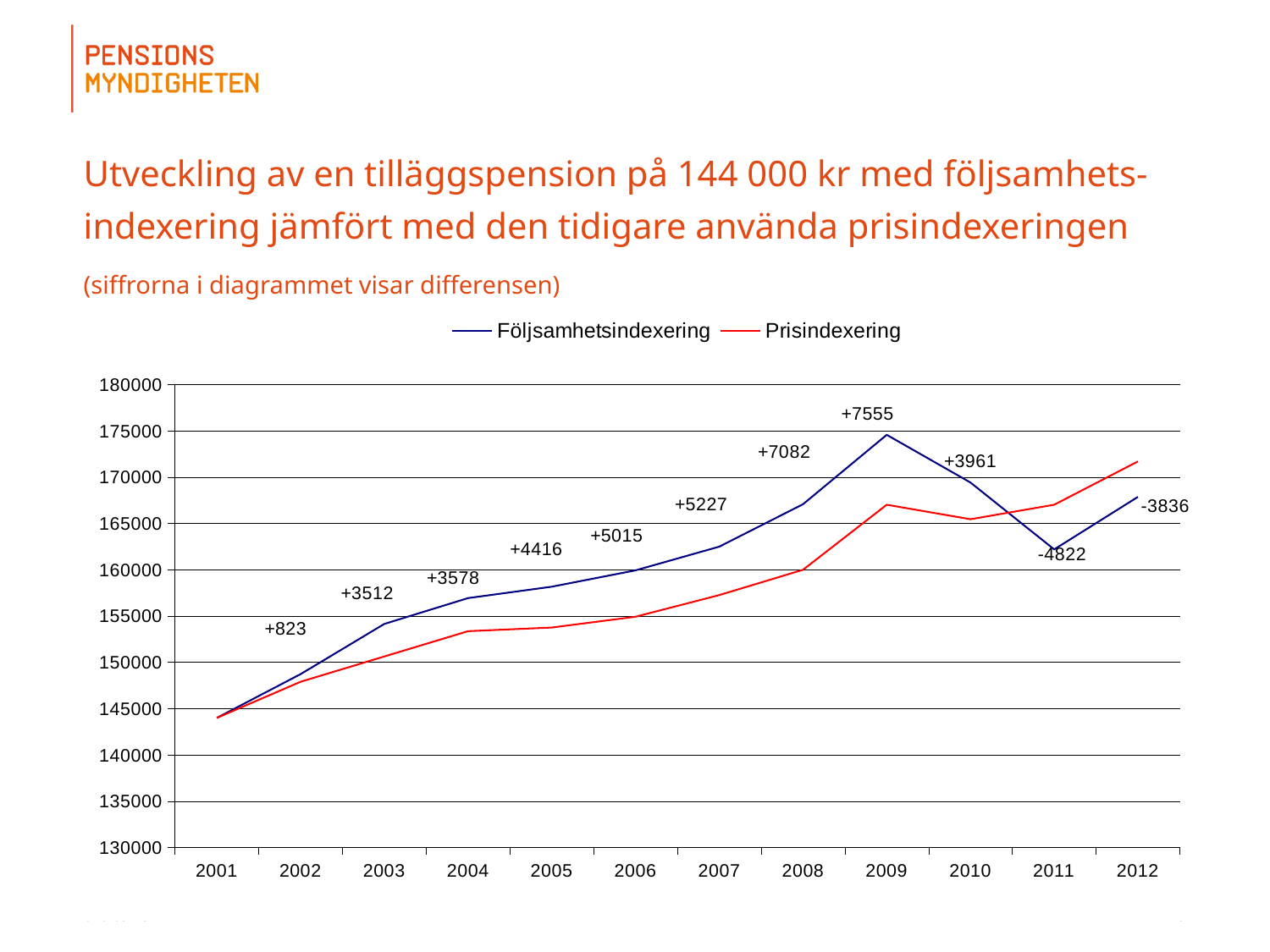
How many years are shown on the x axis? 12 In 2011, which series has the higher value, Följsamhetsindexering or Prisindexering? Prisindexering What difference is labelled on the chart for 2002? +823 In which year is the labelled difference between the two series the lowest (most negative)? 2011 Does the Prisindexering line rise or fall overall from 2001 to 2012? rise Is the value for Följsamhetsindexering in 2011 greater or less than 165000? less What difference is labelled on the chart for 2011? -4822 What difference is labelled on the chart for 2009? +7555 How many series does the legend list? 2 In which year is the labelled difference between the two series the largest positive value? 2009 What kind of chart is shown on the slide? line chart Is the value for Följsamhetsindexering in 2009 greater or less than 170000? greater